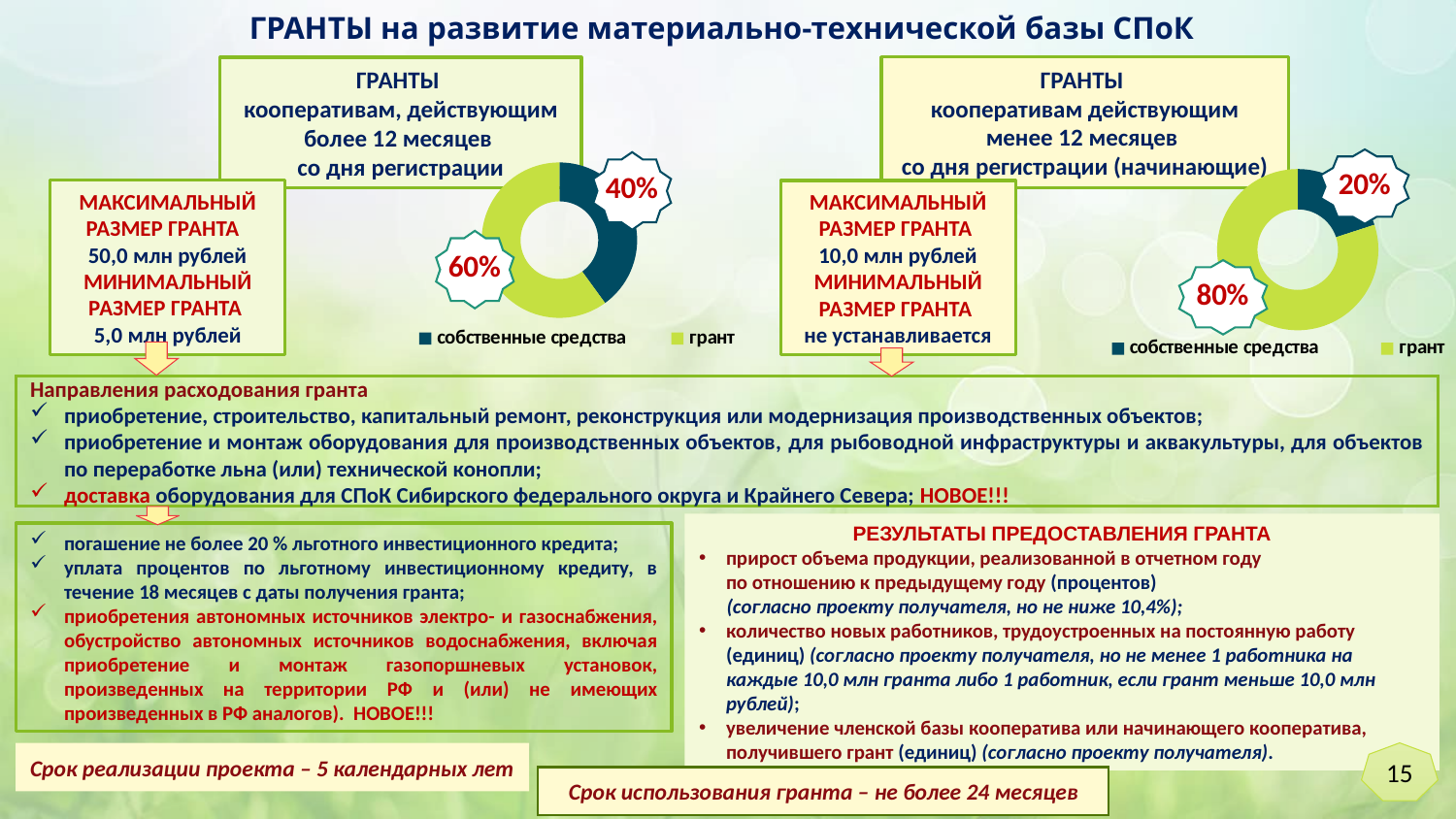
What type of chart is the left chart? Donut (pie) chart On the left chart, what share is labelled for собственные средства? 40% On the left chart, which slice is larger: собственные средства or грант? грант On the right chart, which colour represents грант? Light green On the left chart, what is the difference between the грант share and the собственные средства share? 20% How many slices does the right chart have? 2 On the right chart, what share is labelled for грант? 80% On the left chart, what share is labelled for грант? 60% On the right chart, what share is labelled for собственные средства? 20% On the right chart, what is the difference between the грант share and the собственные средства share? 60% How many entries does the legend of the left chart list? 2 On the right chart, which slice is the smallest? собственные средства